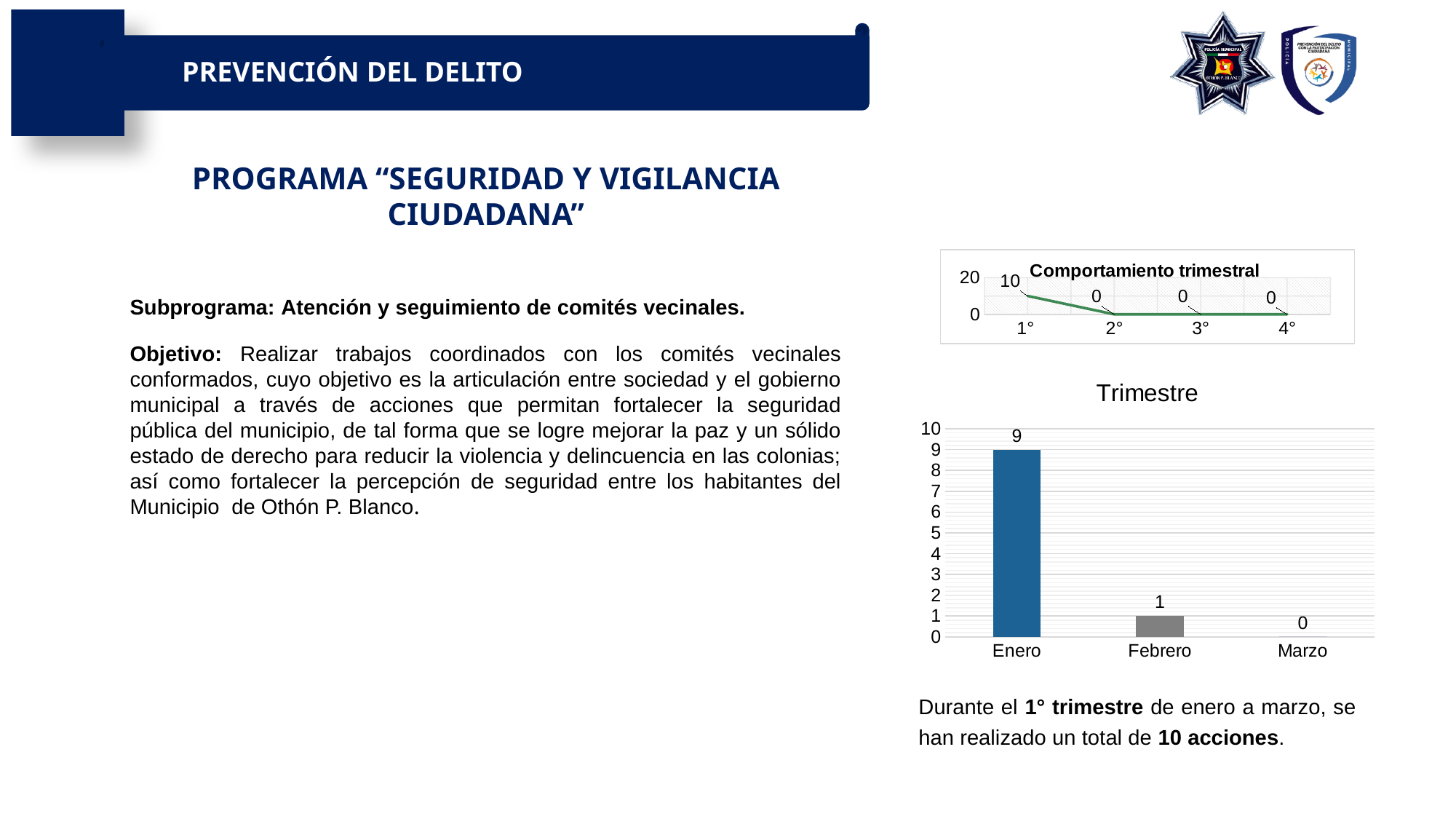
In the "Trimestre" chart, what is the value for Febrero? 1 In the "Trimestre" chart, what is the difference between the values for Enero and Febrero? 8 In the "Trimestre" chart, what is the value for Enero? 9 In the "Trimestre" chart, which month has the highest value? Enero In the "Trimestre" chart, which month has the lowest value? Marzo In the "Comportamiento trimestral" chart, how many points are plotted? 4 In the "Trimestre" chart, do the values rise or fall from Enero to Marzo? Fall What kind of chart is the "Trimestre" chart? Bar chart In the "Trimestre" chart, how many months are shown on the x axis? 3 In the "Comportamiento trimestral" chart, what is the value for 1°? 10 In the "Trimestre" chart, which is larger, the value for Enero or the value for Febrero? Enero In the "Trimestre" chart, what is the value for Marzo? 0